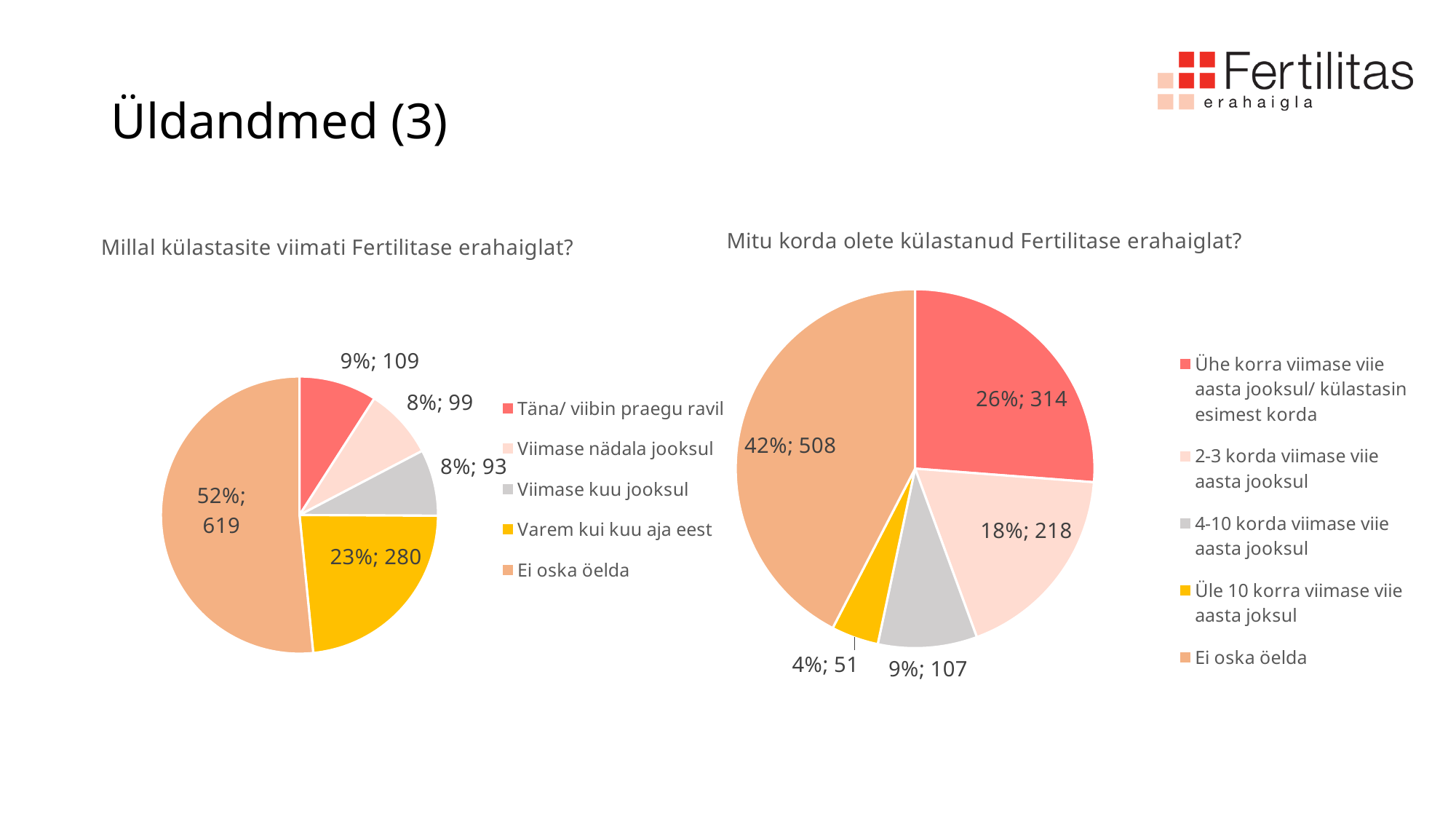
In the right chart 'Mitu korda olete külastanud Fertilitase erahaiglat?', what count is shown for '2-3 korda viimase viie aasta jooksul'? 218 In the right chart 'Mitu korda olete külastanud Fertilitase erahaiglat?', what percentage share does 'Üle 10 korra viimase viie aasta joksul' have? 4% What type of chart is used for 'Mitu korda olete külastanud Fertilitase erahaiglat?'? Pie chart In the right chart 'Mitu korda olete külastanud Fertilitase erahaiglat?', which is larger: the count for '4-10 korda viimase viie aasta jooksul' or for 'Üle 10 korra viimase viie aasta joksul'? 4-10 korda viimase viie aasta jooksul In the left chart 'Millal külastasite viimati Fertilitase erahaiglat?', what colour is the 'Varem kui kuu aja eest' slice? Yellow In the left chart 'Millal külastasite viimati Fertilitase erahaiglat?', which category has the smallest count? Viimase kuu jooksul In the left chart 'Millal külastasite viimati Fertilitase erahaiglat?', what count is shown for 'Varem kui kuu aja eest'? 280 In the right chart 'Mitu korda olete külastanud Fertilitase erahaiglat?', which category has the largest share? Ei oska öelda In the left chart 'Millal külastasite viimati Fertilitase erahaiglat?', what percentage share does 'Ei oska öelda' have? 52% In the right chart 'Mitu korda olete külastanud Fertilitase erahaiglat?', what is the difference in count between 'Ei oska öelda' and 'Ühe korra viimase viie aasta jooksul/ külastasin esimest korda'? 194 How many slices does the left chart 'Millal külastasite viimati Fertilitase erahaiglat?' have? 5 In the left chart 'Millal külastasite viimati Fertilitase erahaiglat?', what is the difference in count between 'Täna/ viibin praegu ravil' and 'Viimase nädala jooksul'? 10